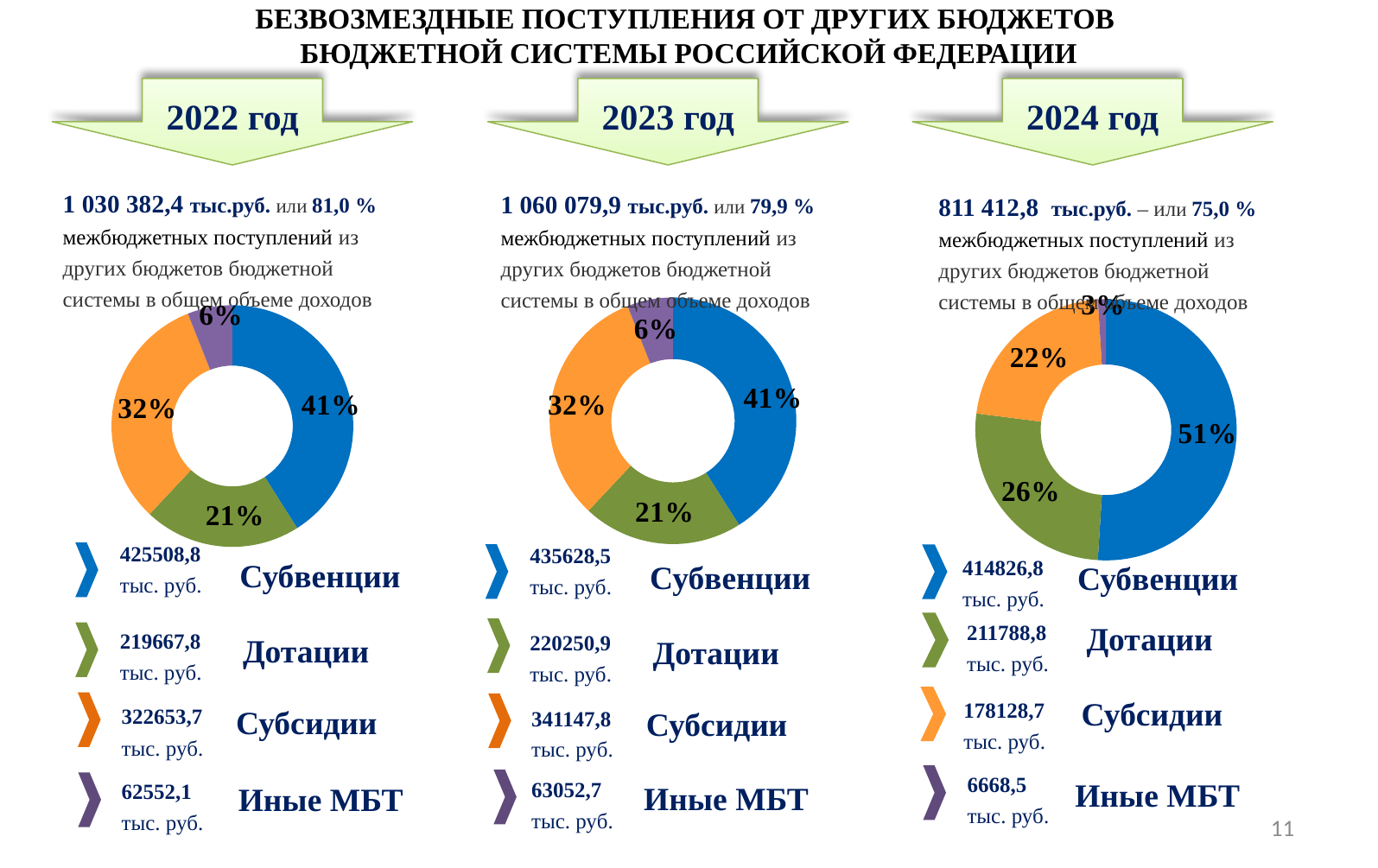
In the 2024 год chart, which category has the largest slice? Субвенции In the 2022 год chart, what share is labelled for Субсидии (the orange slice)? 32% What kind of chart is used for the 2022 год data? pie chart (donut) In the 2022 год chart, what is the difference in percentage points between the Субвенции slice and the Дотации slice? 20 percentage points In the 2024 год chart, which slice is larger: Дотации or Субсидии? Дотации In the 2024 год chart, what share is labelled for Субвенции (the blue slice)? 51% In the 2023 год chart, what share is labelled for Иные МБТ (the purple slice)? 6% In the 2022 год chart, which category has the smallest slice? Иные МБТ How many categories are shown in each donut chart's legend? 4